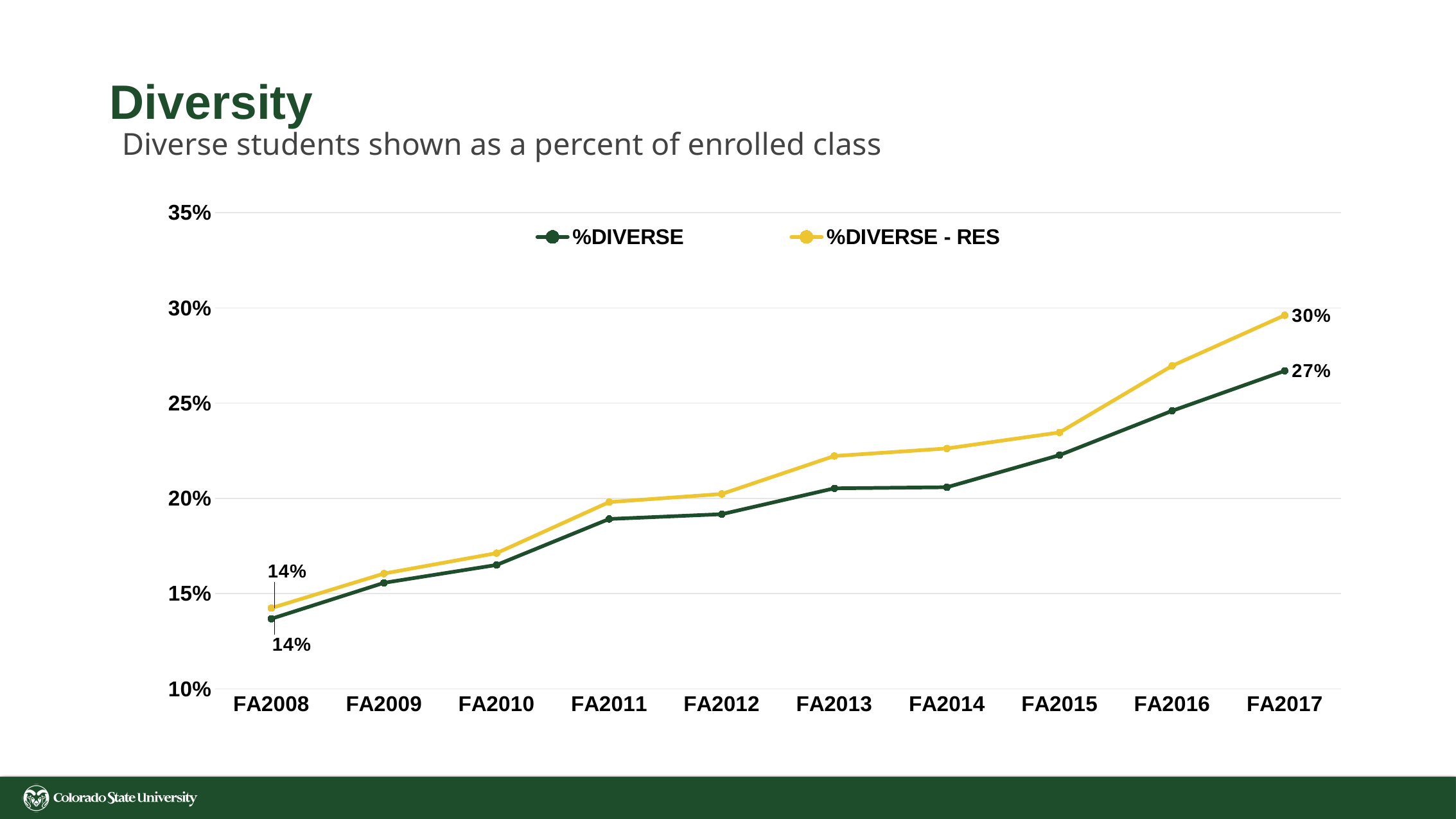
Which series is drawn in yellow? %DIVERSE - RES What is the value of %DIVERSE - RES for FA2017? 30% What kind of chart is shown on the slide? Line chart Which series has the higher value in FA2016? %DIVERSE - RES What is the value of %DIVERSE for FA2008? 14% What is the difference between %DIVERSE - RES and %DIVERSE in FA2017? 3% How many fall terms are shown on the x axis? 10 How many series does the legend list? 2 Do the %DIVERSE values rise or fall from FA2008 to FA2017? Rise Is the value for %DIVERSE in FA2013 greater or less than 25%? less What is the value of %DIVERSE for FA2017? 27% Is the value for %DIVERSE - RES in FA2015 greater or less than 20%? greater